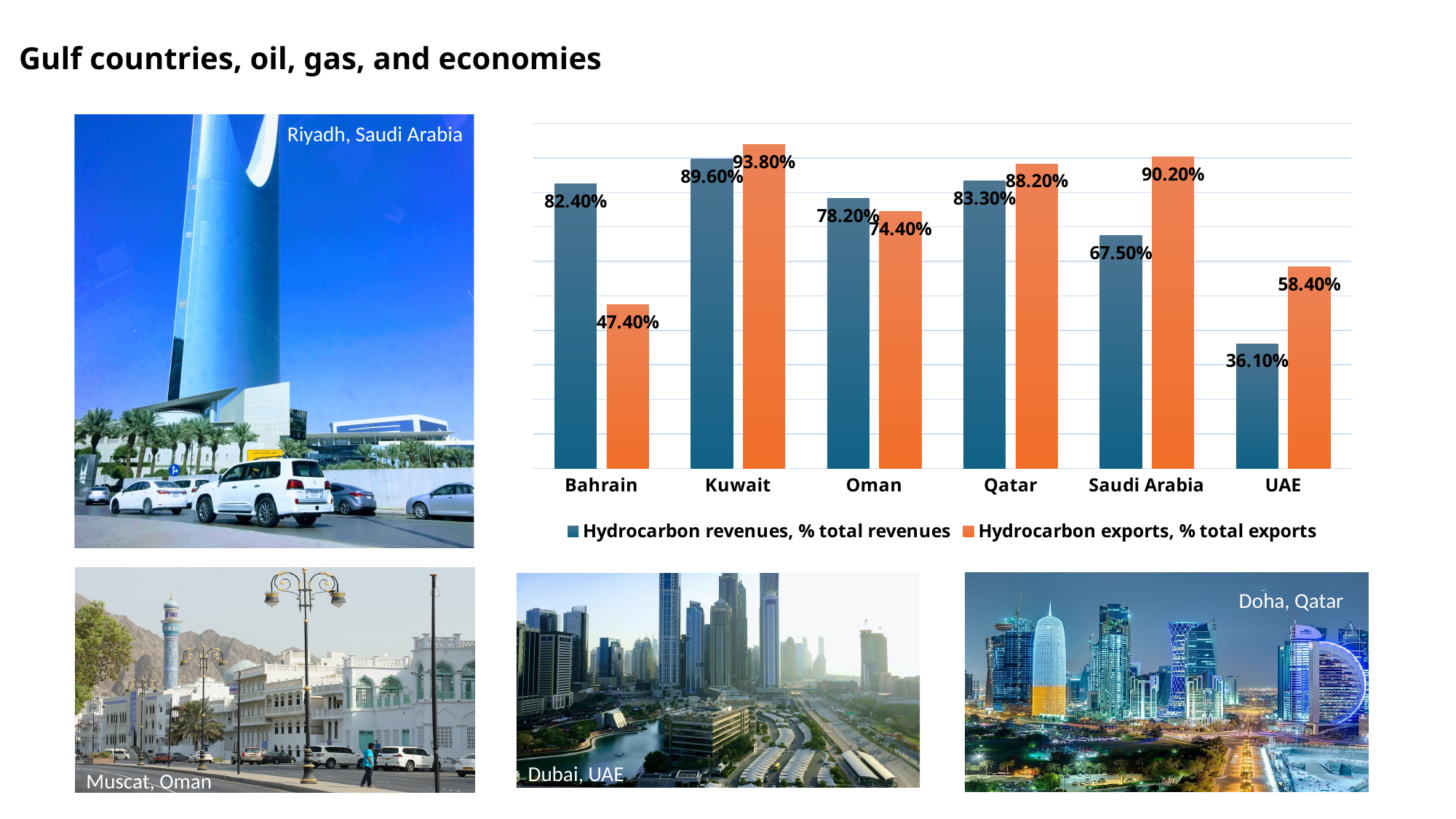
How many series does the chart legend list? 2 How many countries are shown on the x axis of the chart? 6 For Saudi Arabia, which is larger: Hydrocarbon revenues, % total revenues or Hydrocarbon exports, % total exports? Hydrocarbon exports, % total exports Which country has the lowest Hydrocarbon exports, % total exports? Bahrain What is the value of Hydrocarbon exports, % total exports for Saudi Arabia? 90.20% What is the value of Hydrocarbon revenues, % total revenues for Bahrain? 82.40% Which country has the highest Hydrocarbon revenues, % total revenues? Kuwait What type of chart is shown on the slide? Bar chart What is the difference between Hydrocarbon exports, % total exports for Kuwait and for Oman? 19.40% What is the difference between Hydrocarbon revenues, % total revenues and Hydrocarbon exports, % total exports for Bahrain? 35.00% What is the value of Hydrocarbon exports, % total exports for UAE? 58.40% Which country has the lowest Hydrocarbon revenues, % total revenues? UAE